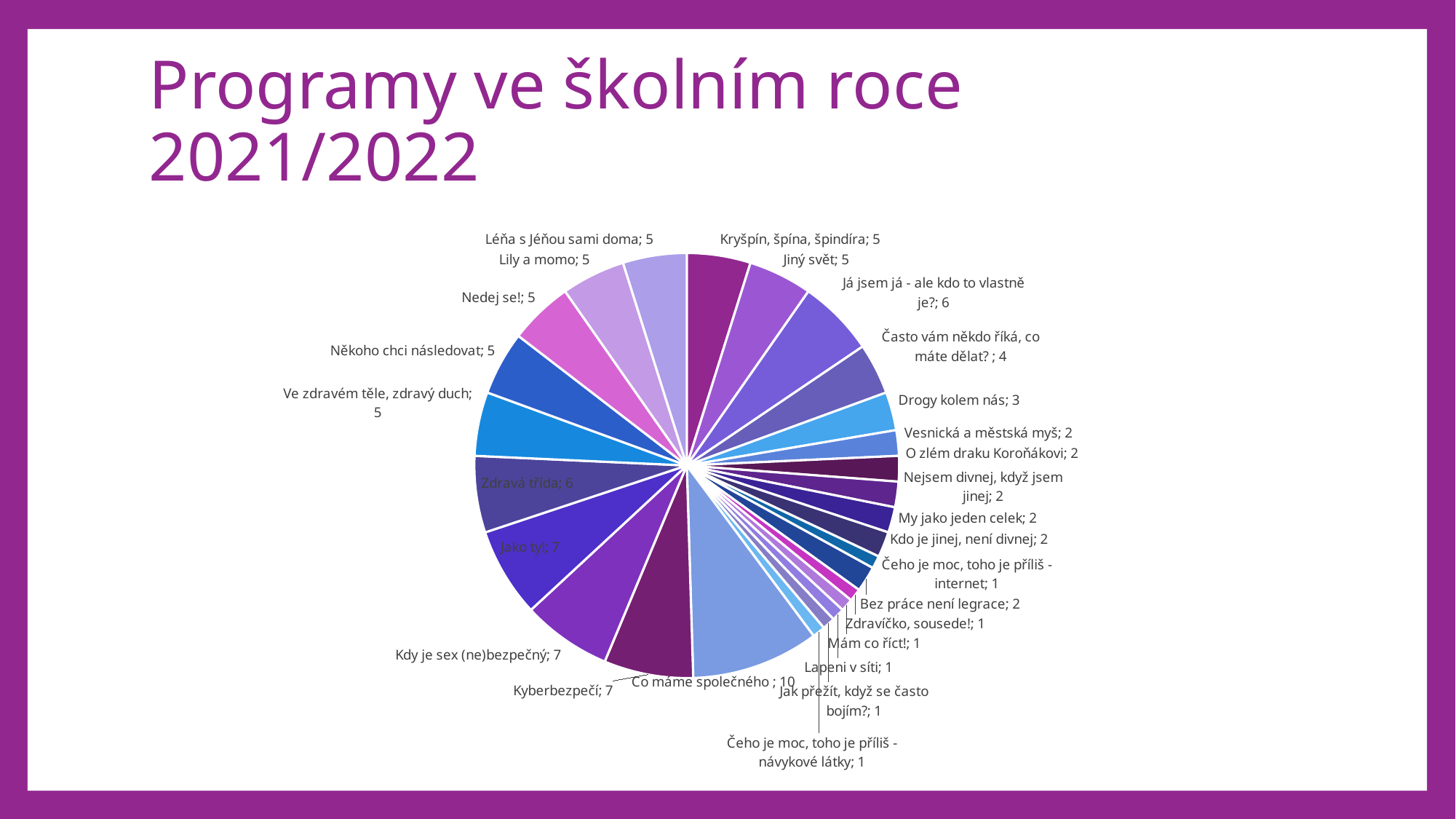
What is the value for "Kyberbezpečí"? 7 What is the value for "Často vám někdo říká, co máte dělat?"? 4 What is the difference between the values for "Co máme společného" and "Jako ty!"? 3 Which has a larger value, "Já jsem já - ale kdo to vlastně je?" or "Drogy kolem nás"? Já jsem já - ale kdo to vlastně je? How many programs (slices) are shown in the pie chart? 27 What is the value for "Zdravá třída"? 6 What is the value for "Drogy kolem nás"? 3 What is the value for "Co máme společného"? 10 Which has a larger value, "Kdy je sex (ne)bezpečný" or "Nedej se!"? Kdy je sex (ne)bezpečný Which program has the highest value in the pie chart? Co máme společného What is the title of the slide containing the pie chart? Programy ve školním roce 2021/2022 What type of chart is shown on the slide? pie chart